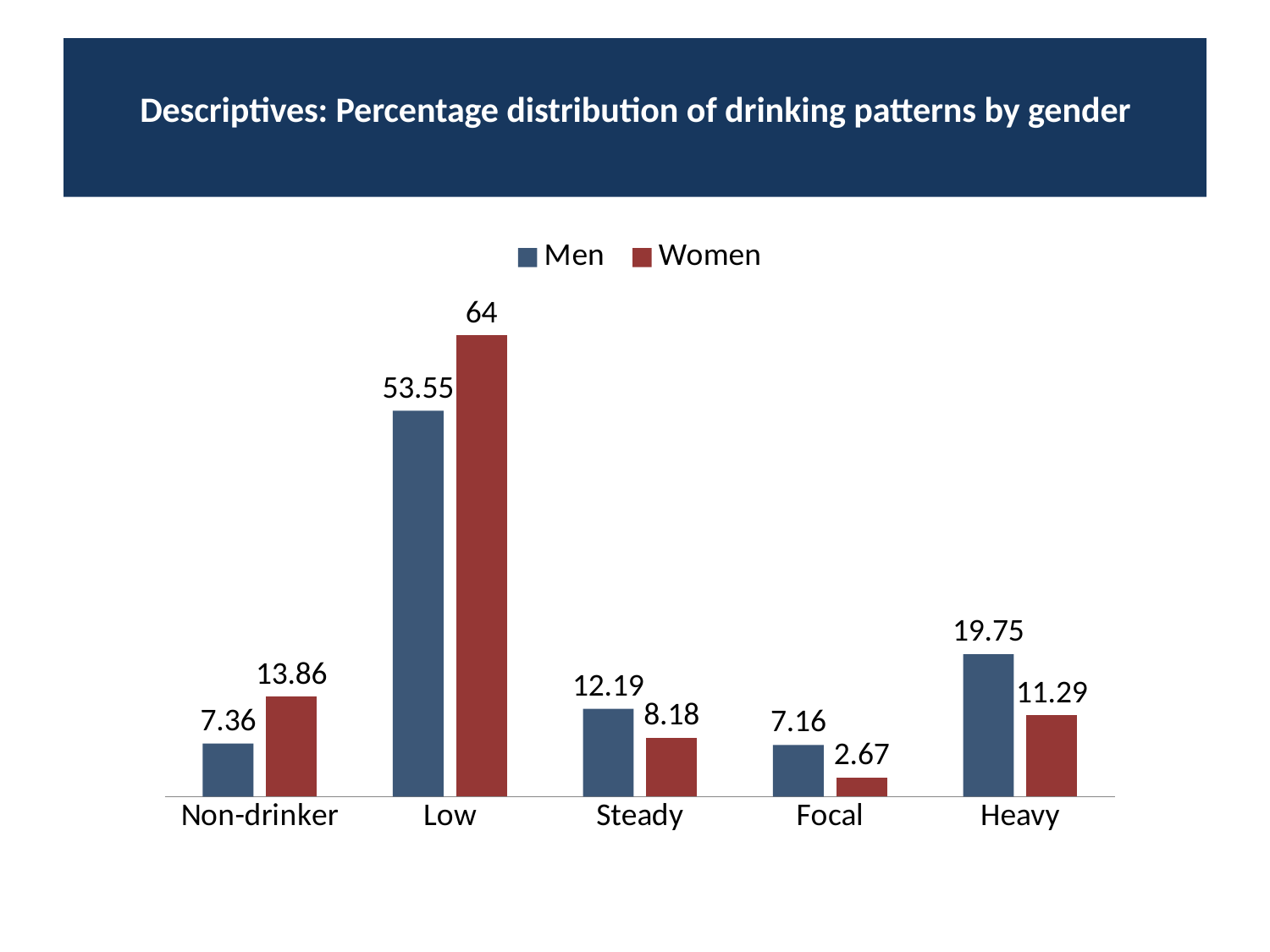
Which category has the lowest value for Men? Focal What is the title of the slide? Descriptives: Percentage distribution of drinking patterns by gender What is the value for Women in the Non-drinker category? 13.86 Which category has the highest value for Women? Low What is the difference between the Men and Women values in the Heavy category? 8.46 What kind of chart is shown on the slide? Bar chart What is the difference between the Women and Men values in the Low category? 10.45 How many categories are shown on the x axis? 5 In the Steady category, which is larger, the value for Men or for Women? Men What is the value for Women in the Focal category? 2.67 How many series does the legend list? 2 What is the value for Men in the Low category? 53.55